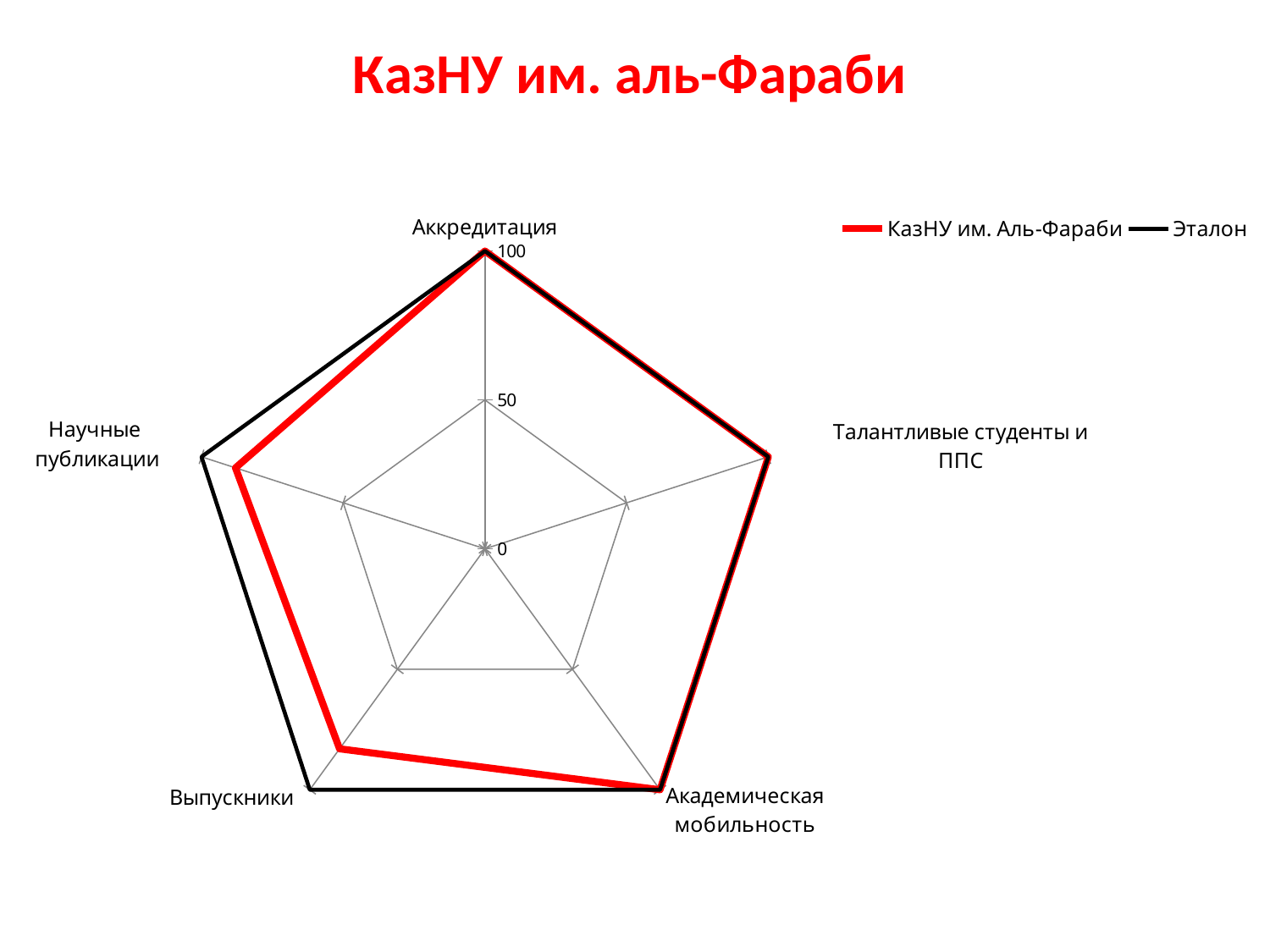
How many categories (axes) does the radar chart have? 5 Is the КазНУ им. Аль-Фараби value for Научные публикации greater or less than 50? greater What is the value of the Эталон series for Аккредитация? 100 What kind of chart is shown on the slide? Radar chart Is the КазНУ им. Аль-Фараби value for Выпускники greater or less than 50? greater What is the value of the Эталон series for Выпускники? 100 For Выпускники, which series has the larger value: КазНУ им. Аль-Фараби or Эталон? Эталон For Научные публикации, which series has the larger value: КазНУ им. Аль-Фараби or Эталон? Эталон Which series is drawn in red? КазНУ им. Аль-Фараби What is the maximum value shown on the radar chart's axis scale? 100 How many series does the legend list? 2 What is the title of the slide? КазНУ им. аль-Фараби